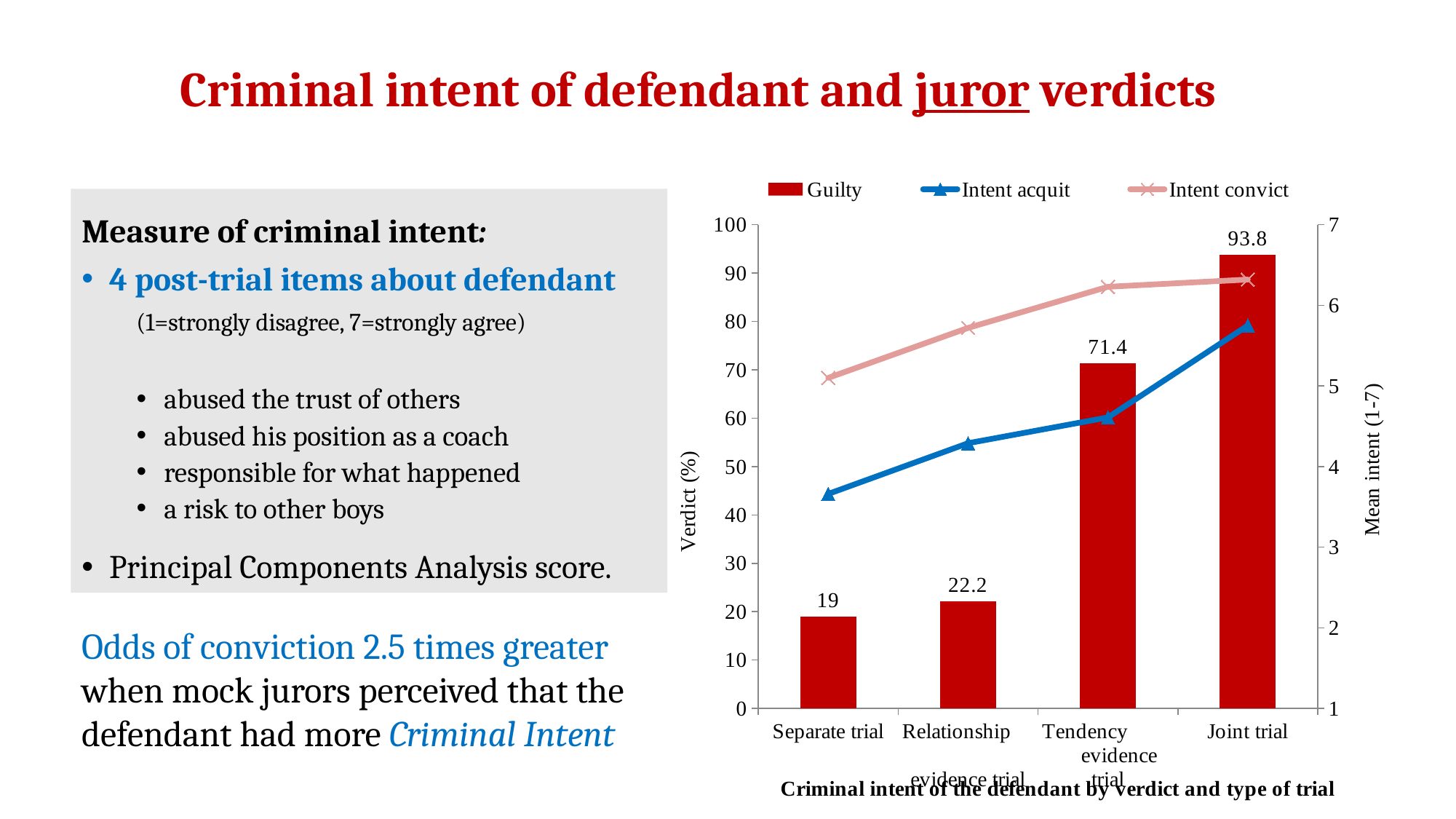
What is the Guilty verdict percentage for the Separate trial? 19 What is the Guilty verdict percentage for the Joint trial? 93.8 Which type of trial has the lowest Guilty verdict percentage? Separate trial Do the Guilty verdict percentages rise or fall from Separate trial to Joint trial? rise What is the Guilty verdict percentage for the Tendency evidence trial? 71.4 Is the Intent acquit value for the Separate trial greater or less than 4 on the Mean intent axis? less Is the Intent convict value for the Joint trial greater or less than 6 on the Mean intent axis? greater How many series does the legend list? 3 Which has a higher Guilty verdict percentage, the Relationship evidence trial or the Tendency evidence trial? Tendency evidence trial How many types of trial are shown on the x axis? 4 What is the difference in Guilty verdict percentage between the Joint trial and the Tendency evidence trial? 22.4 Which type of trial has the highest Guilty verdict percentage? Joint trial